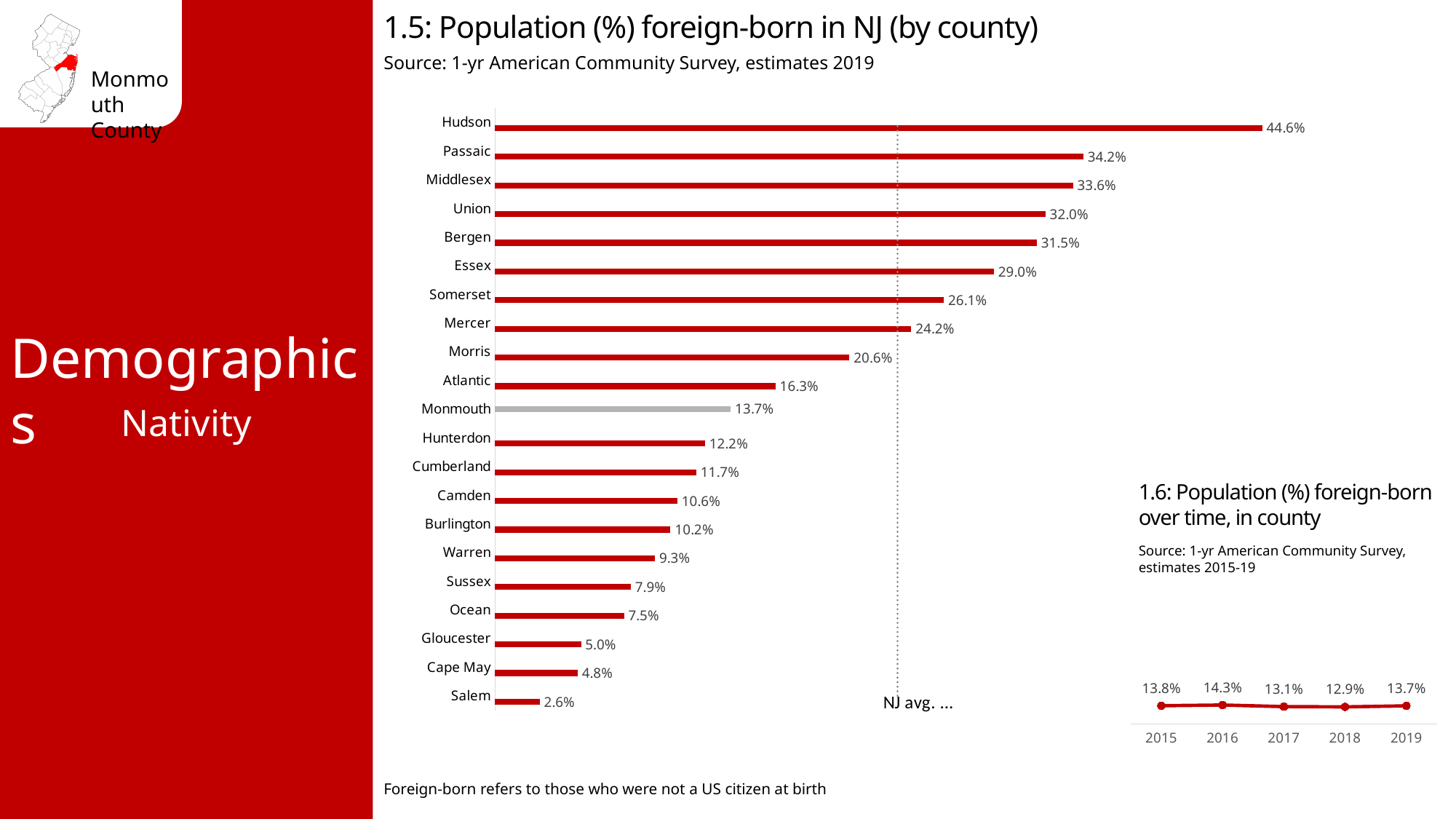
In chart 1.5 (Population (%) foreign-born in NJ by county), what is the value for Hudson? 44.6% In chart 1.5 (Population (%) foreign-born in NJ by county), which county has the lowest value? Salem In chart 1.5 (Population (%) foreign-born in NJ by county), which county's bar is shown in grey rather than red? Monmouth What kind of chart is chart 1.5 (Population (%) foreign-born in NJ by county)? Bar chart In chart 1.6 (Population (%) foreign-born over time, in county), what is the difference between 2016 and 2018? 1.4% In chart 1.5 (Population (%) foreign-born in NJ by county), what is the value for Monmouth? 13.7% In chart 1.5 (Population (%) foreign-born in NJ by county), how many counties are shown? 21 In chart 1.6 (Population (%) foreign-born over time, in county), what is the value for 2016? 14.3% In chart 1.5 (Population (%) foreign-born in NJ by county), which county has the highest value? Hudson In chart 1.5 (Population (%) foreign-born in NJ by county), what is the difference between Passaic and Middlesex? 0.6% In chart 1.6 (Population (%) foreign-born over time, in county), which year has the lowest value? 2018 In chart 1.5 (Population (%) foreign-born in NJ by county), which is larger, Camden or Burlington? Camden